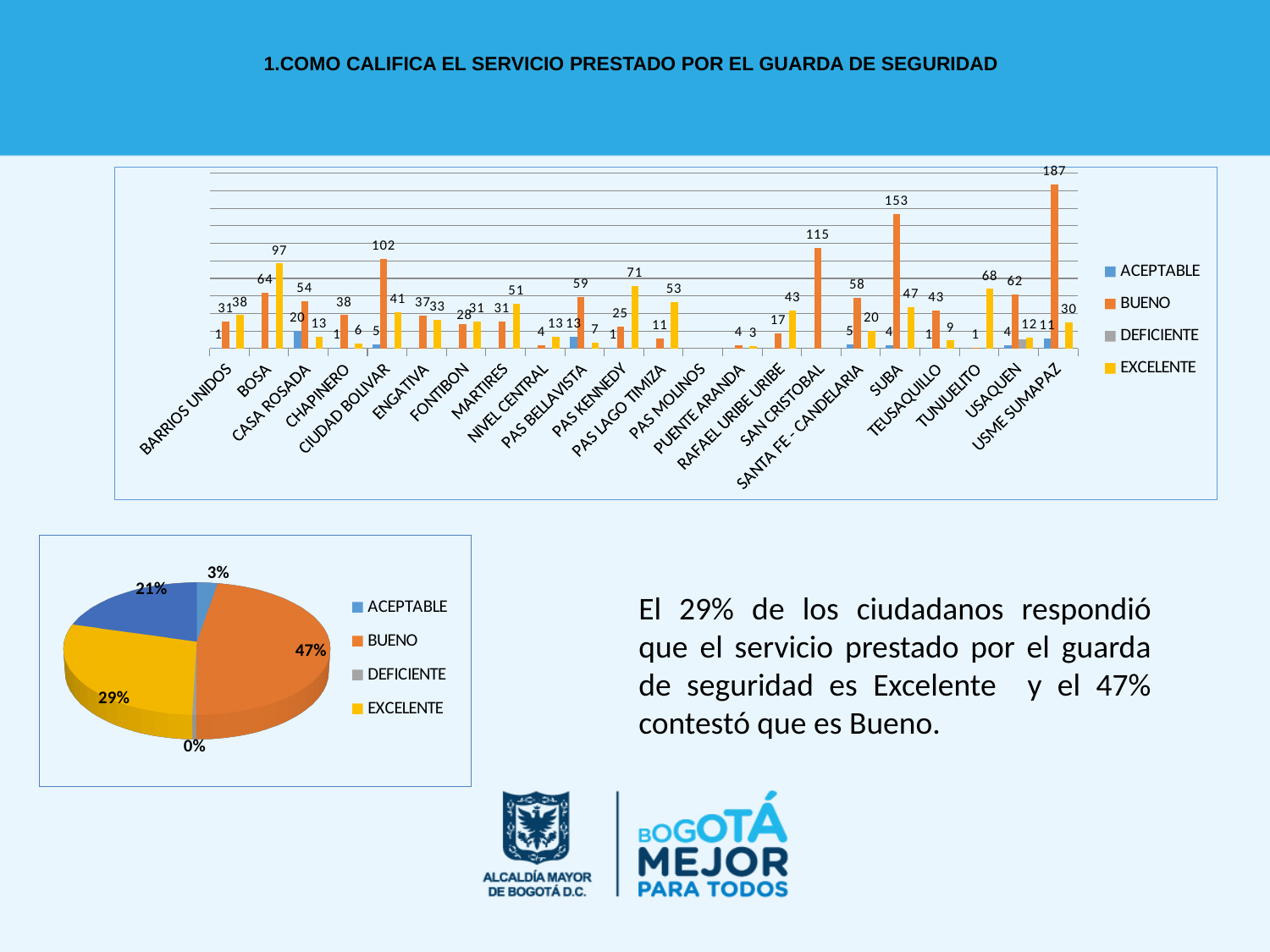
In the top bar chart, which category has the highest BUENO value? USME SUMAPAZ What kind of chart is the chart at the top of the slide? Bar chart In the top bar chart, which is larger for PAS KENNEDY: the BUENO value or the EXCELENTE value? EXCELENTE In the pie chart, what share does ACEPTABLE have? 3% In the top bar chart, what is the difference between the BUENO values for SUBA and SAN CRISTOBAL? 38 In the top bar chart, what colour represents the BUENO series? Orange In the pie chart, what share does BUENO have? 47% How many series does the legend of the top bar chart list? 4 In the top bar chart, what is the BUENO value for USME SUMAPAZ? 187 In the top bar chart, what is the BUENO value for CIUDAD BOLIVAR? 102 In the top bar chart, what is the EXCELENTE value for BOSA? 97 In the pie chart, what share does EXCELENTE have? 29%